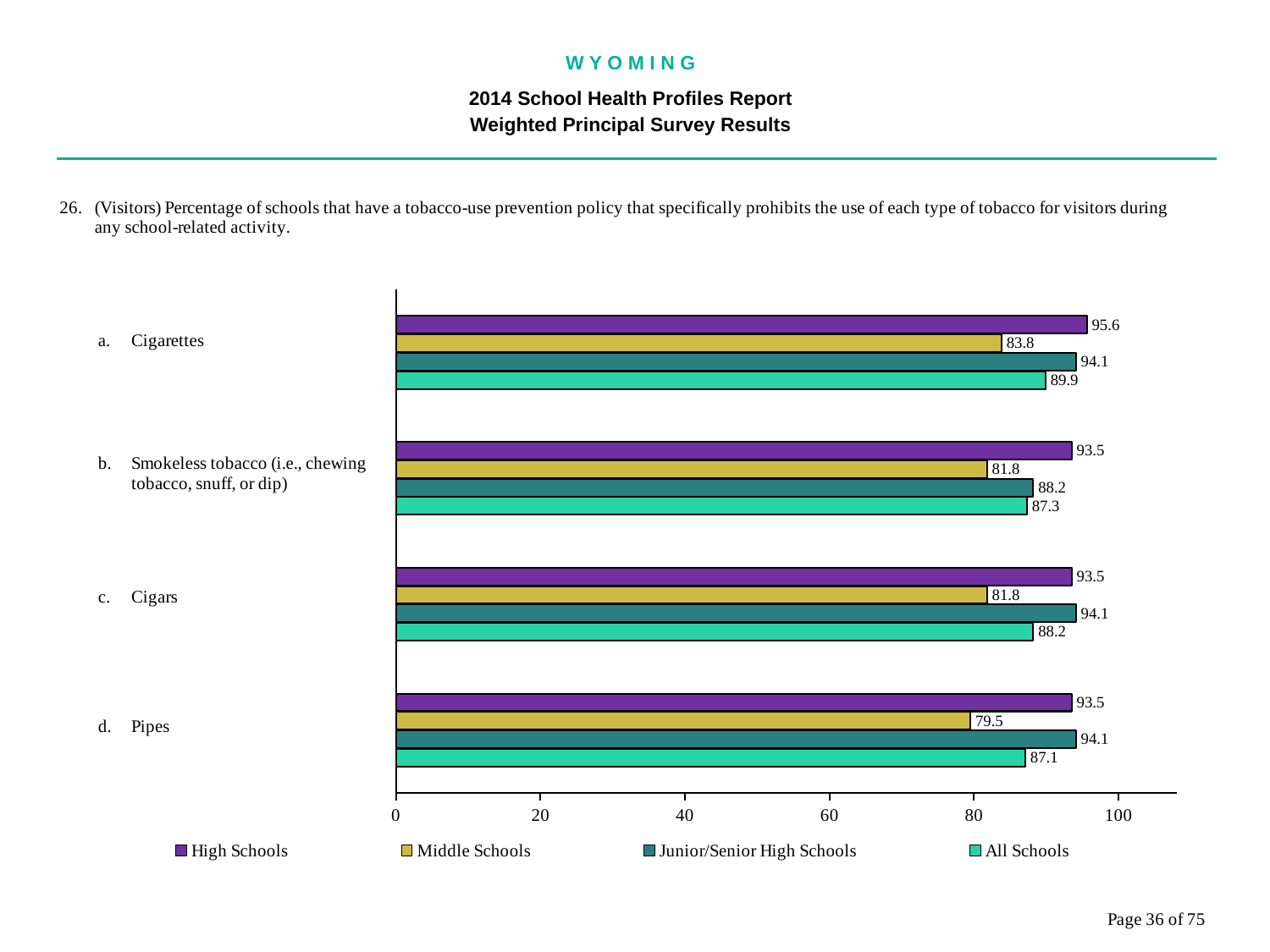
Which category has the highest value for High Schools? Cigarettes Is the value for Middle Schools for Pipes greater or less than 80? less How many series does the legend list? 4 What is the difference between the High Schools and Middle Schools values for Cigarettes? 11.8 What kind of chart is shown on the slide? bar chart What is the value for Junior/Senior High Schools for Cigars? 94.1 What is the value for High Schools for Cigarettes? 95.6 What is the value for Middle Schools for Pipes? 79.5 What is the value for All Schools for Smokeless tobacco? 87.3 Which is larger for Smokeless tobacco: the Junior/Senior High Schools value or the All Schools value? Junior/Senior High Schools Which category has the lowest value for Middle Schools? Pipes How many categories are shown on the chart? 4